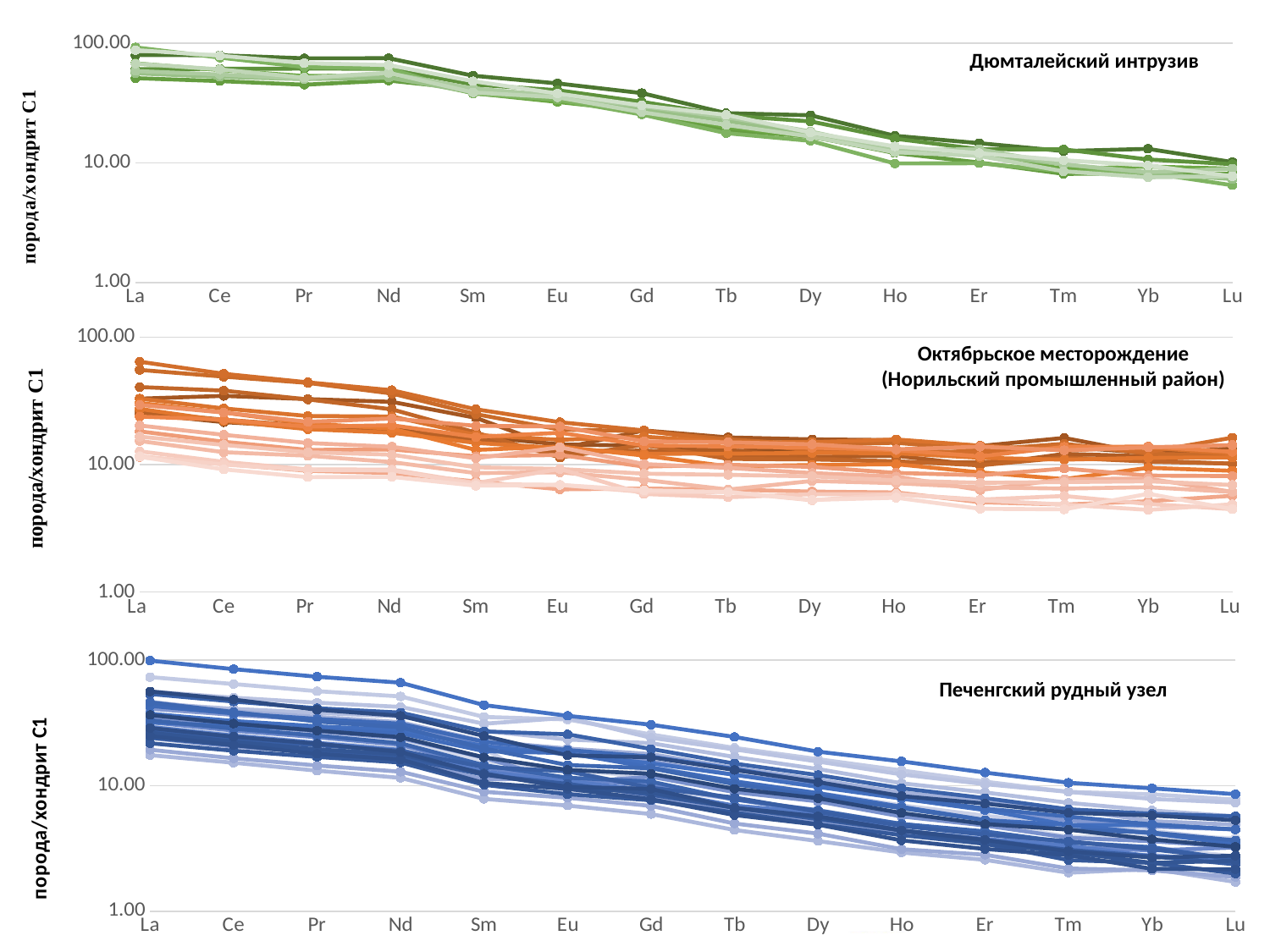
In the bottom chart titled "Печенгский рудный узел", do the values generally rise or fall from La to Lu? fall In the bottom chart titled "Печенгский рудный узел", are the values for Lu greater or less than 10.00? less In the middle chart titled "Октябрьское месторождение", do the values generally rise or fall from La to Lu? fall In the top chart titled "Дюмталейский интрузив", do the values generally rise or fall from La to Lu? fall What is the first category on the x axis of the top chart titled "Дюмталейский интрузив"? La How many charts are shown on the slide? 3 In the middle chart titled "Октябрьское месторождение", are the values for La greater or less than 100.00? less In the middle chart titled "Октябрьское месторождение", are the values for Lu greater or less than 1.00? greater What kind of chart is the top chart titled "Дюмталейский интрузив"? line chart What is the y-axis label of the bottom chart titled "Печенгский рудный узел"? порода/хондрит C1 How many categories are shown along the x axis of the bottom chart titled "Печенгский рудный узел"? 14